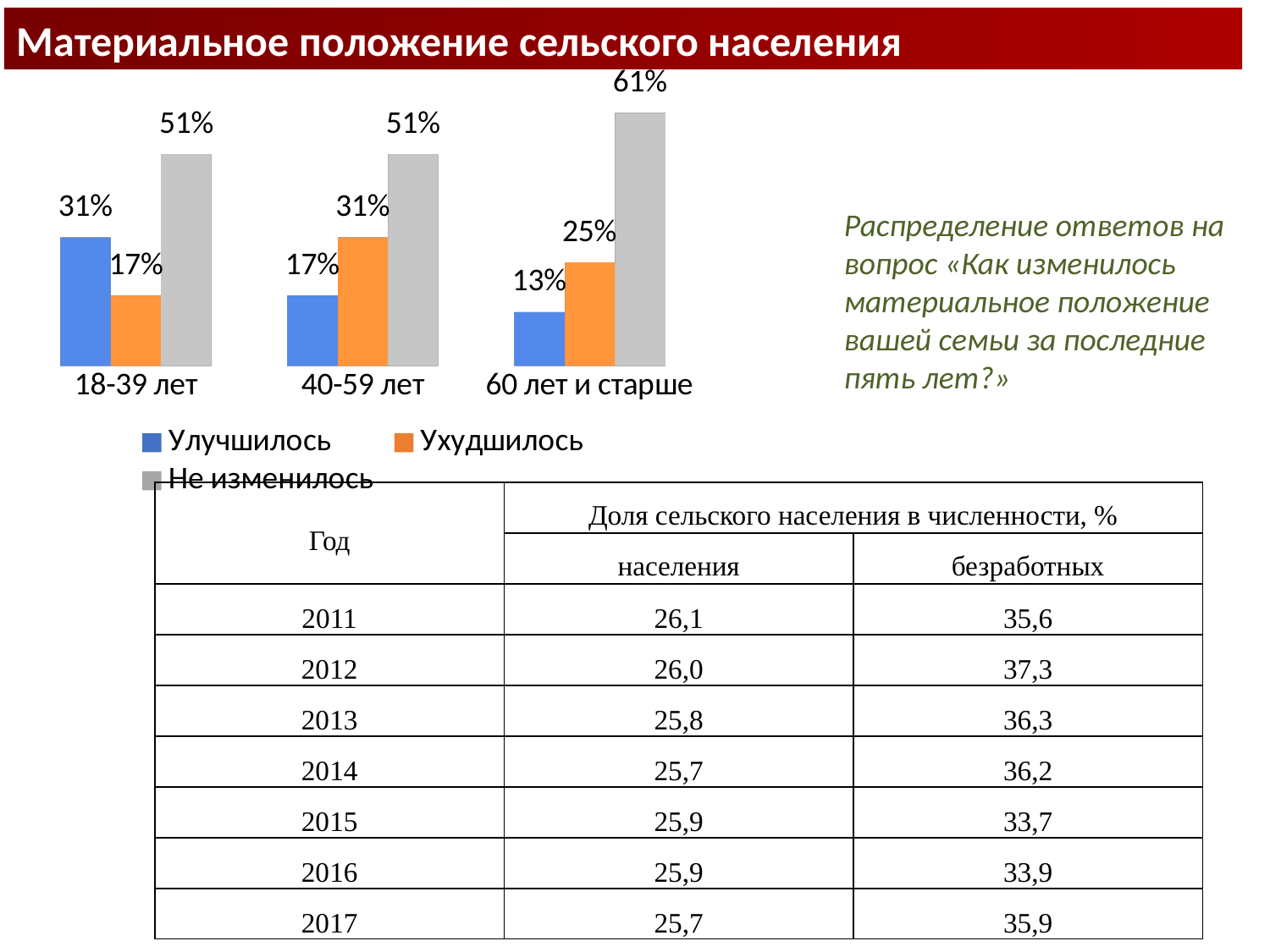
What is the value for «Не изменилось» in the 60 лет и старше group? 61% Which age group has the lowest value for «Улучшилось»? 60 лет и старше In the 40-59 лет group, which is larger: «Улучшилось» or «Ухудшилось»? Ухудшилось Which age group has the highest value for «Не изменилось»? 60 лет и старше How does the value for «Улучшилось» change across the age groups from 18-39 лет to 60 лет и старше? It falls What is the value for «Улучшилось» in the 60 лет и старше group? 13% What type of chart is shown on the slide? Bar chart What is the difference between «Не изменилось» and «Улучшилось» in the 18-39 лет group? 20% What is the value for «Улучшилось» in the 18-39 лет group? 31% What is the value for «Ухудшилось» in the 40-59 лет group? 31% How many age-group categories are shown on the chart? 3 How many series does the chart legend list? 3